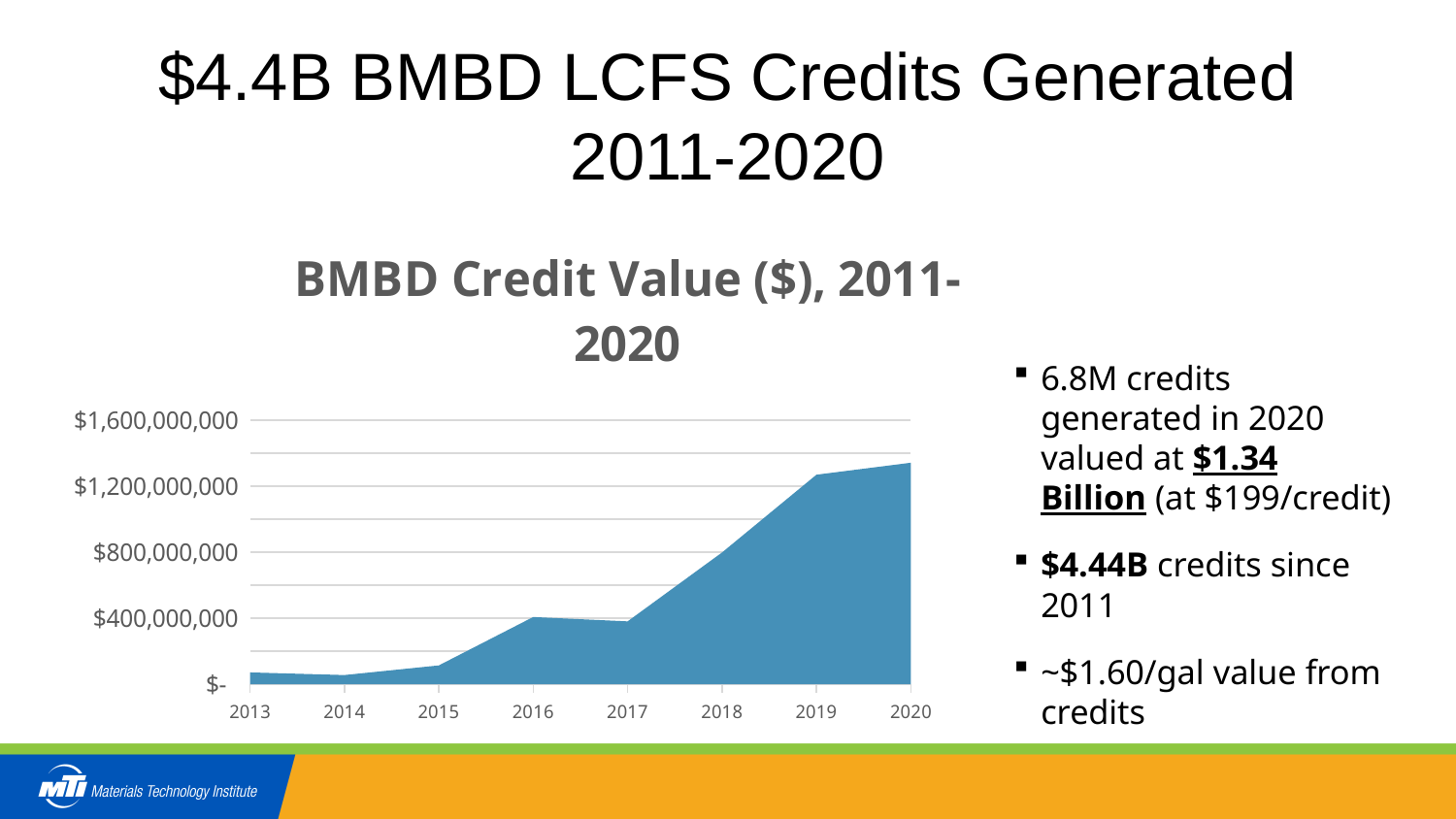
Is the value for 2017 greater or less than $800,000,000? less Is the value for 2019 greater or less than $1,200,000,000? greater Which year has the highest BMBD credit value in the chart? 2020 Is the value for 2018 greater or less than $400,000,000? greater What is the title of the chart? BMBD Credit Value ($), 2011-2020 Do the BMBD credit values generally rise or fall from 2013 to 2020? Rise Which year has the larger BMBD credit value, 2015 or 2016? 2016 How many years are shown on the x axis of the chart? 8 What is the first year shown on the x axis of the chart? 2013 What kind of chart is shown on the slide? Area chart Which year has the larger BMBD credit value, 2016 or 2018? 2018